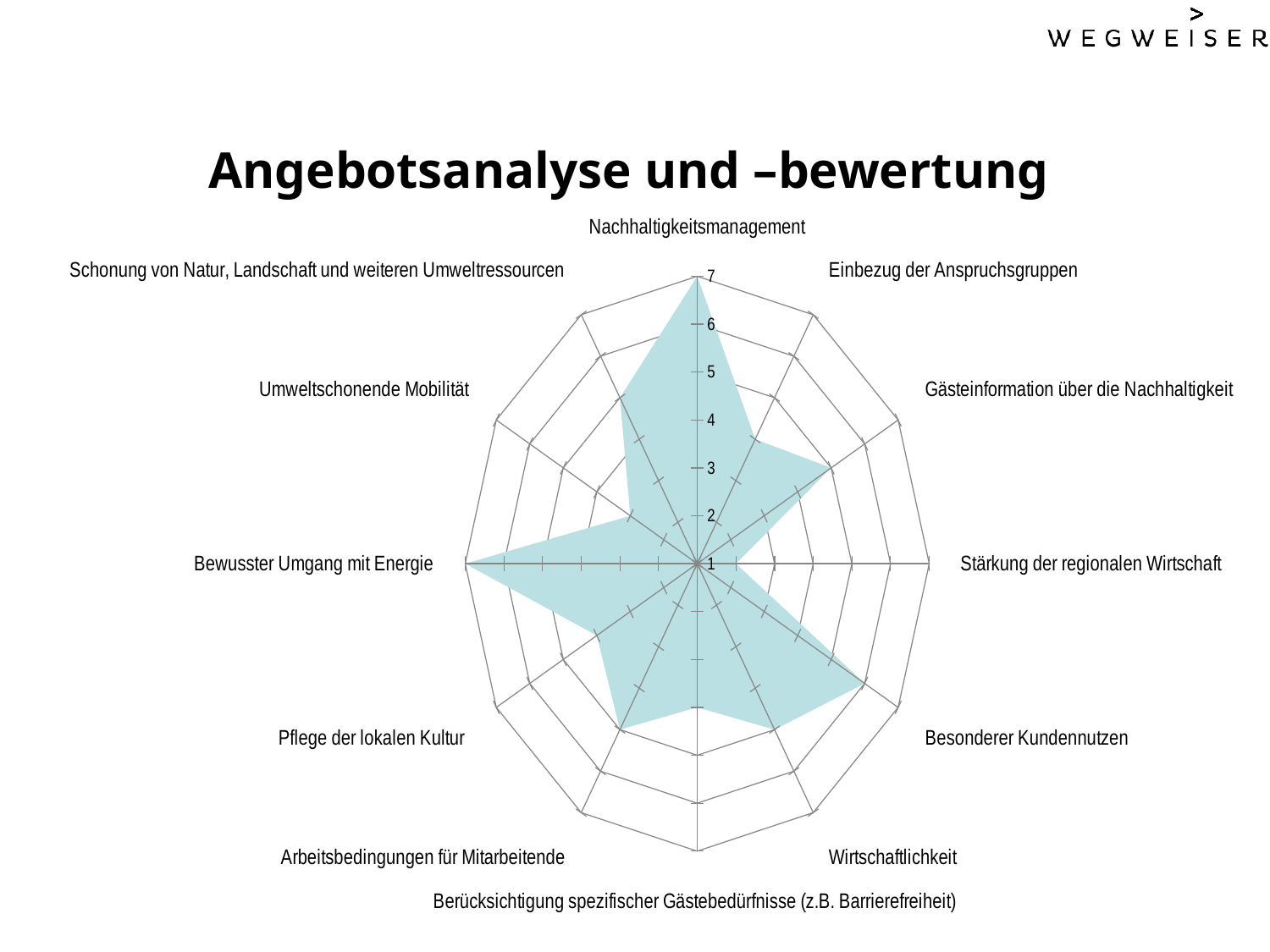
Which has the larger value, Nachhaltigkeitsmanagement or Stärkung der regionalen Wirtschaft? Nachhaltigkeitsmanagement Is the value for Stärkung der regionalen Wirtschaft greater or less than 3? less Is the value for Wirtschaftlichkeit greater or less than 3? greater Which has the larger value, Besonderer Kundennutzen or Umweltschonende Mobilität? Besonderer Kundennutzen Is the value for Umweltschonende Mobilität greater or less than 4? less How many categories (axes) does the radar chart have? 12 What is the value for Bewusster Umgang mit Energie? 7 What is the title of the slide containing the radar chart? Angebotsanalyse und –bewertung What kind of chart is shown on the slide? radar chart What is the value for Nachhaltigkeitsmanagement? 7